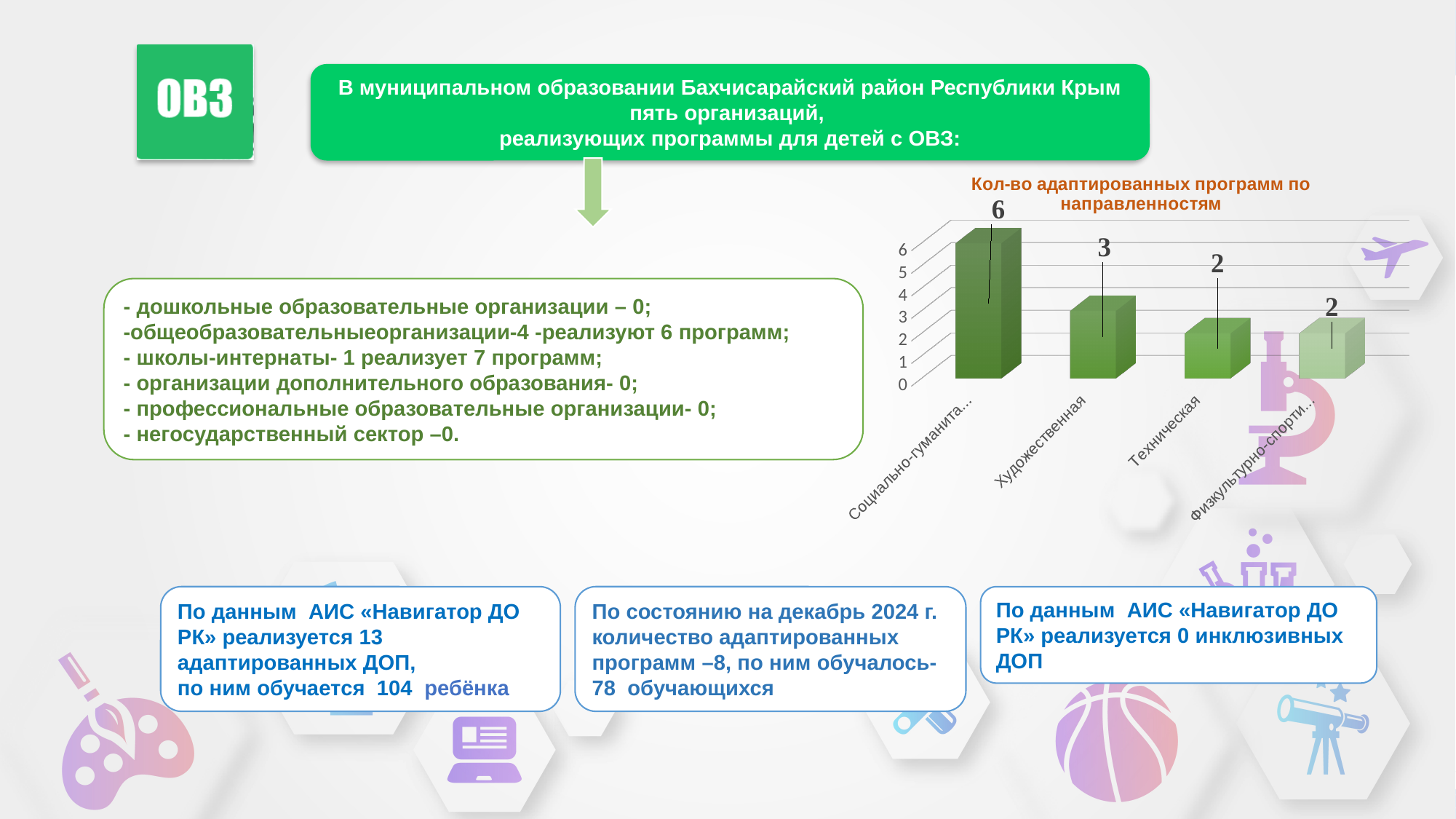
Which is larger: the value for Художественная or the value for Техническая? Художественная What is the value for Художественная in the chart? 3 What is the value for Техническая in the chart? 2 What is the value of the first (leftmost) bar in the chart? 6 What is the title of the chart on the slide? Кол-во адаптированных программ по направленностям Do the values generally rise or fall from left to right along the x axis? fall What is the difference between the first bar's value and the value for Художественная? 3 What type of chart is shown on the slide? bar chart What is the difference between the values for Художественная and Техническая? 1 How many categories are shown in the chart? 4 What is the value of the last (rightmost) bar in the chart? 2 Which category has the highest value in the chart? Социально-гуманита... (the first bar)